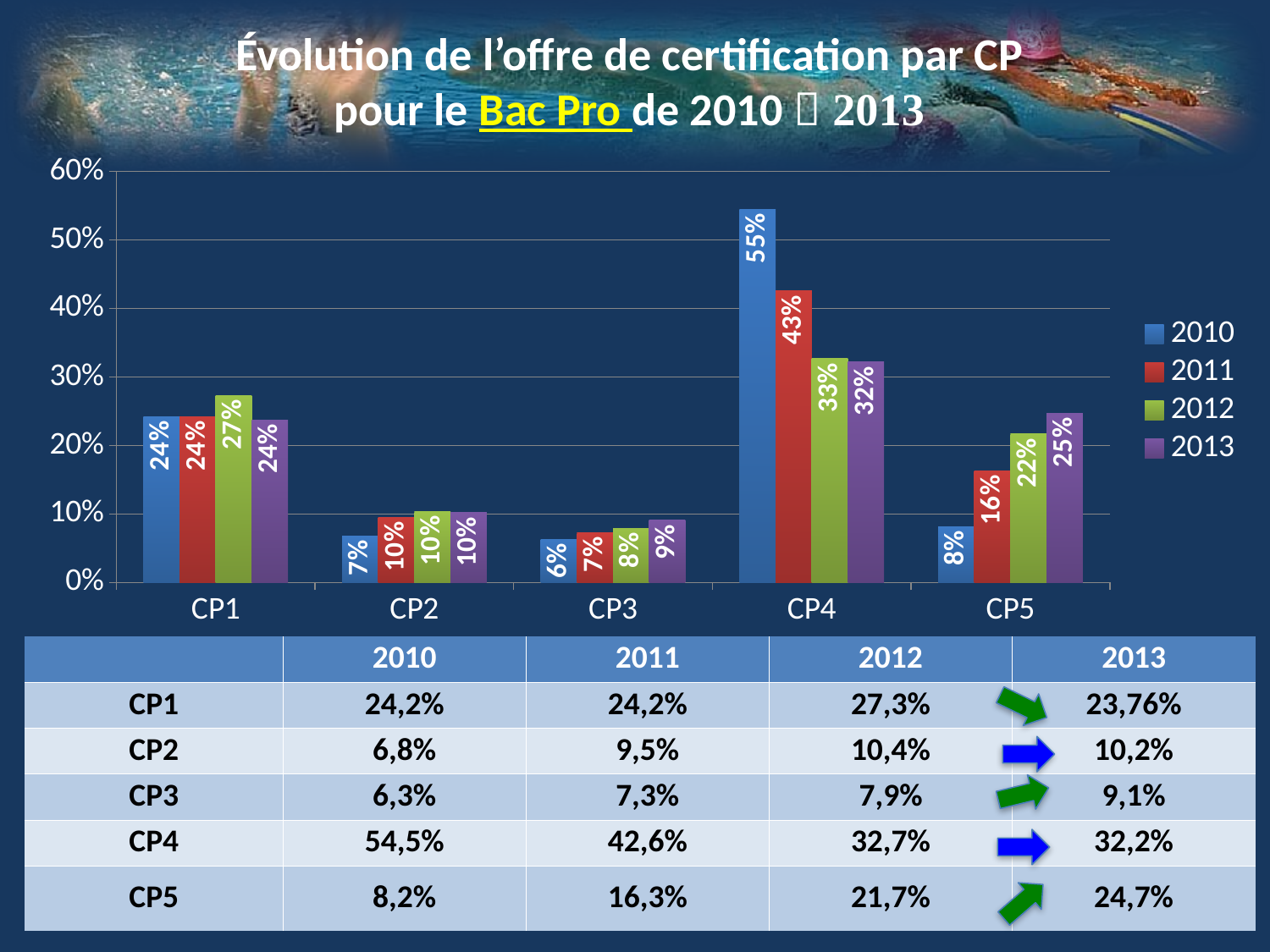
Using the chart's data labels, what is the difference between the 2010 and 2011 values for CP4? 12% What kind of chart is shown on the slide? bar chart Which category has the highest value for the 2010 series in the chart? CP4 According to the chart's data label, what is the value for CP1 in 2012? 27% Which colour represents the 2012 series in the chart legend? green According to the chart's data label, what is the value for CP5 in 2013? 25% In the chart, do the values for CP5 rise or fall from 2010 to 2013? rise How many series does the chart legend list? 4 In the chart, which is larger for CP5: the 2011 value or the 2013 value? 2013 According to the chart's data label, what is the value for CP4 in 2010? 55% Which category has the lowest value for the 2010 series in the chart? CP3 How many categories (CP groups) are shown on the x axis of the chart? 5